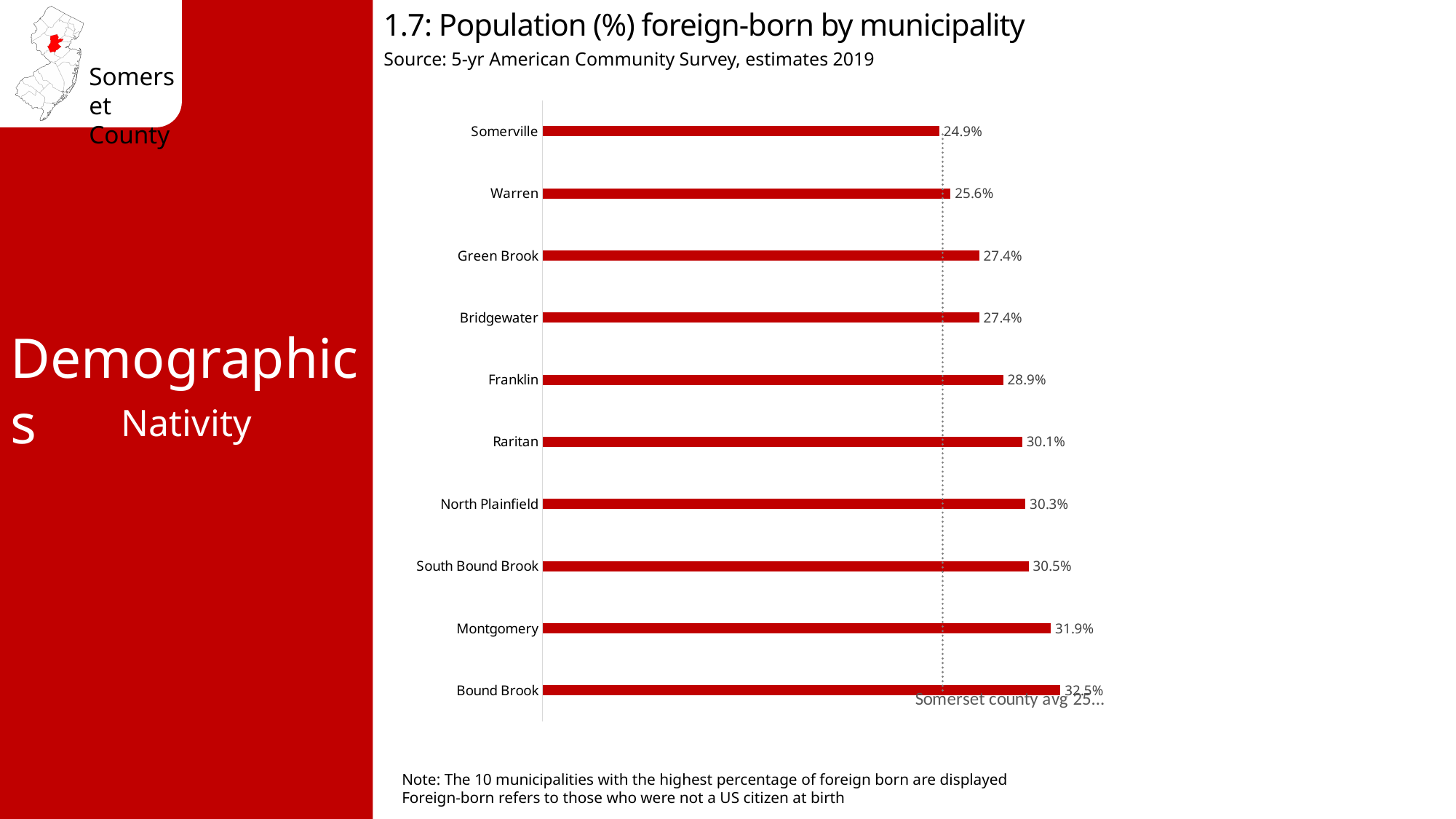
What is the difference in percentage points between Bound Brook and Somerville? 7.6 What is the difference in percentage points between South Bound Brook and North Plainfield? 0.2 What is the percentage of foreign-born population in Franklin? 28.9% How many municipalities are shown in the chart? 10 Which has a higher foreign-born percentage, Raritan or Warren? Raritan Which municipality has the highest percentage of foreign-born population? Bound Brook What is the percentage of foreign-born population in Montgomery? 31.9% What kind of chart is used to show the foreign-born population by municipality? Bar chart What is the source of the data shown in the chart? 5-yr American Community Survey, estimates 2019 Which two municipalities have the same foreign-born percentage of 27.4%? Green Brook and Bridgewater Which municipality has the lowest percentage of foreign-born population? Somerville What is the percentage of foreign-born population in Somerville? 24.9%